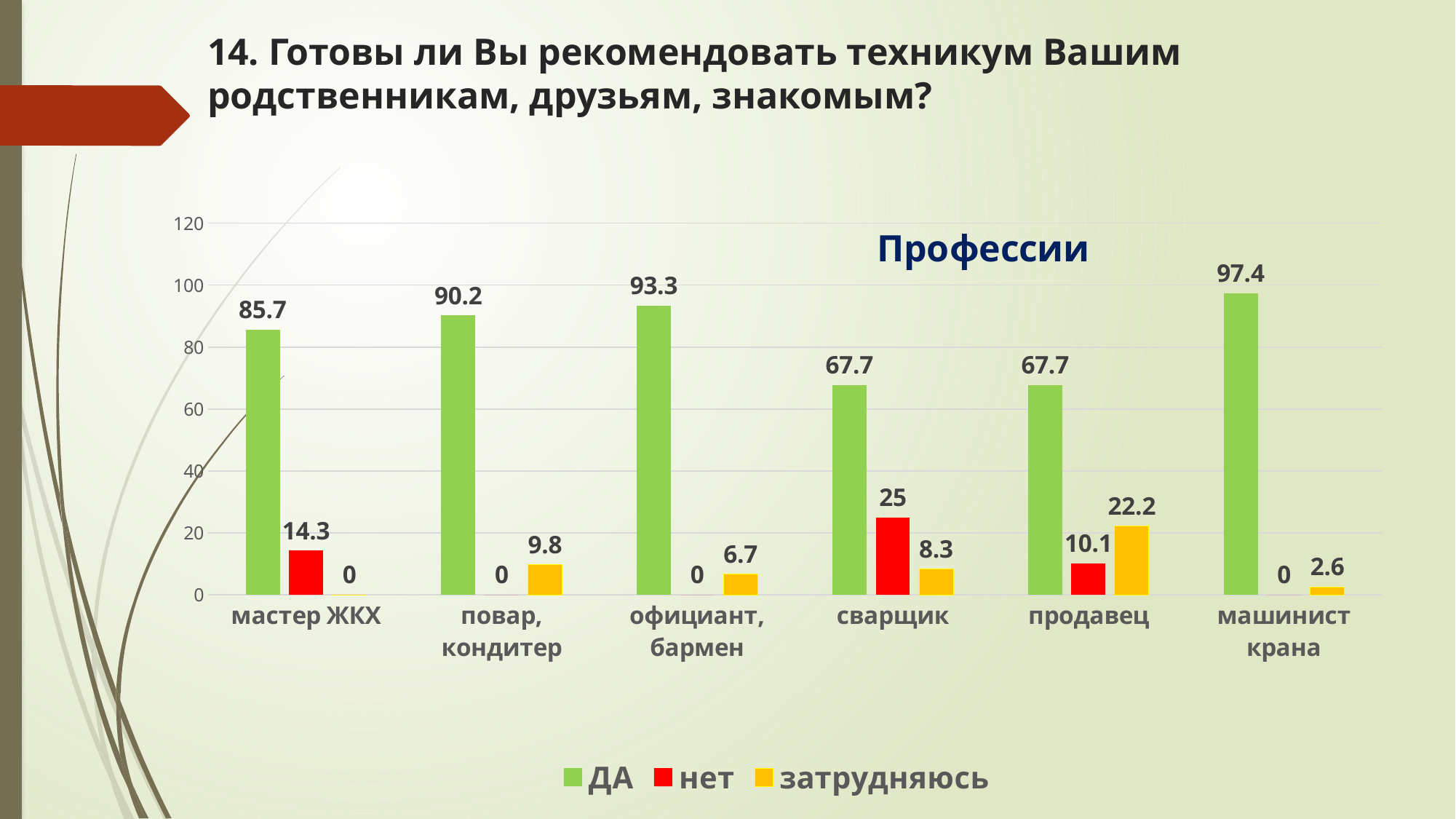
What is the value of "затрудняюсь" for "продавец"? 22.2 Which profession has the highest "затрудняюсь" value? продавец How many professions are shown on the x axis? 6 What kind of chart is shown on the slide? bar chart What colour represents the "нет" series? red How many series does the legend list? 3 What is the value of "нет" for "сварщик"? 25 What is the difference between the "ДА" values for "официант, бармен" and "сварщик"? 25.6 Which profession has the highest "ДА" value? машинист крана What is the value of "ДА" for "машинист крана"? 97.4 Which is larger: the "нет" value for "мастер ЖКХ" or for "продавец"? мастер ЖКХ Is the "ДА" value for "повар, кондитер" greater or less than 80? greater